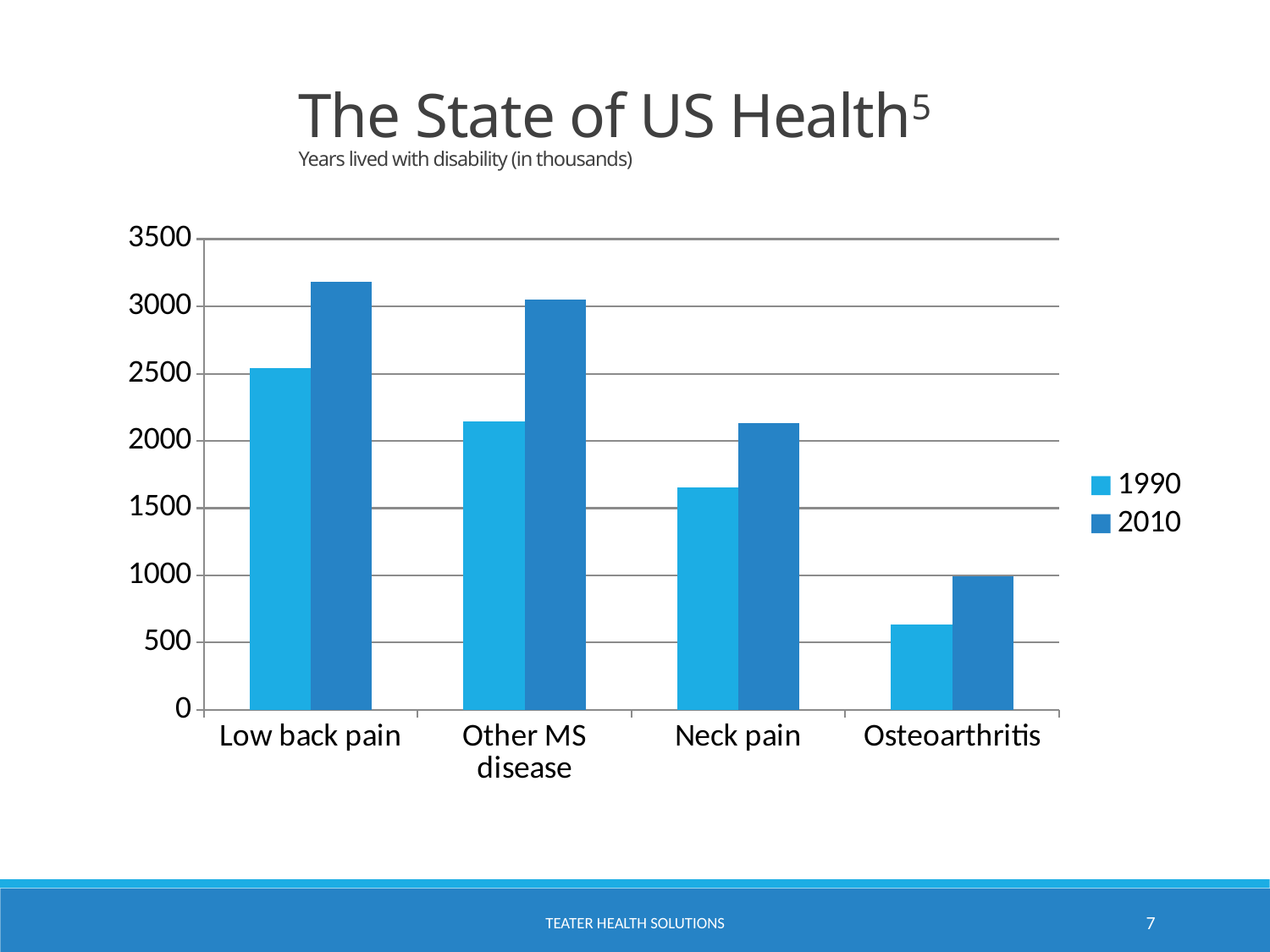
For Neck pain, which year has the larger value, 1990 or 2010? 2010 How many series does the legend list? 2 What are the two entries in the legend? 1990 and 2010 Which condition has the lowest value for 1990? Osteoarthritis Do the 2010 values rise or fall moving from left to right across the categories? fall For 1990, which is larger: Low back pain or Other MS disease? Low back pain Is the value for Low back pain in 2010 greater or less than 3000? greater Is the value for Neck pain in 1990 greater or less than 2000? less What kind of chart is shown on the slide? bar chart How many condition categories are shown on the x axis? 4 Which condition has the highest value for 2010? Low back pain Is the value for Osteoarthritis in 1990 greater or less than 1000? less